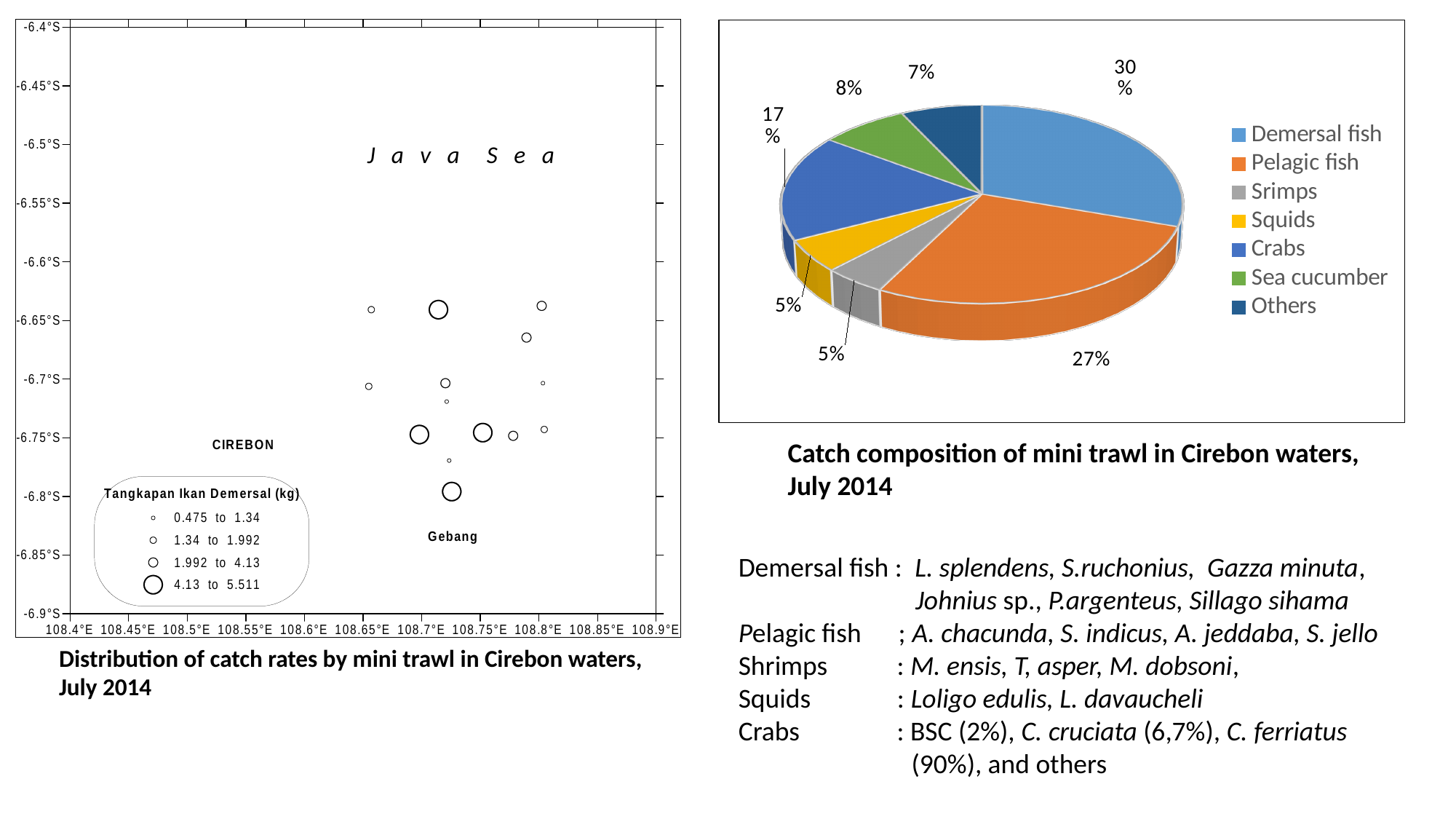
In the pie chart 'Catch composition of mini trawl in Cirebon waters, July 2014', what share does Pelagic fish have? 27% In the pie chart 'Catch composition of mini trawl in Cirebon waters, July 2014', what is the difference in share between Demersal fish and Pelagic fish? 3% In the pie chart 'Catch composition of mini trawl in Cirebon waters, July 2014', which category has the largest share? Demersal fish In the pie chart 'Catch composition of mini trawl in Cirebon waters, July 2014', what share does Demersal fish have? 30% How many categories does the legend of the pie chart 'Catch composition of mini trawl in Cirebon waters, July 2014' list? 7 In the pie chart 'Catch composition of mini trawl in Cirebon waters, July 2014', what share does Crabs have? 17% In the pie chart 'Catch composition of mini trawl in Cirebon waters, July 2014', what share does Others have? 7% In the pie chart 'Catch composition of mini trawl in Cirebon waters, July 2014', which is larger, the share for Crabs or the share for Sea cucumber? Crabs In the pie chart 'Catch composition of mini trawl in Cirebon waters, July 2014', what share does Sea cucumber have? 8% In the pie chart 'Catch composition of mini trawl in Cirebon waters, July 2014', what is the difference in share between Crabs and Others? 10% What kind of chart is the chart titled 'Catch composition of mini trawl in Cirebon waters, July 2014'? Pie chart In the pie chart 'Catch composition of mini trawl in Cirebon waters, July 2014', what colour is the Pelagic fish slice? Orange